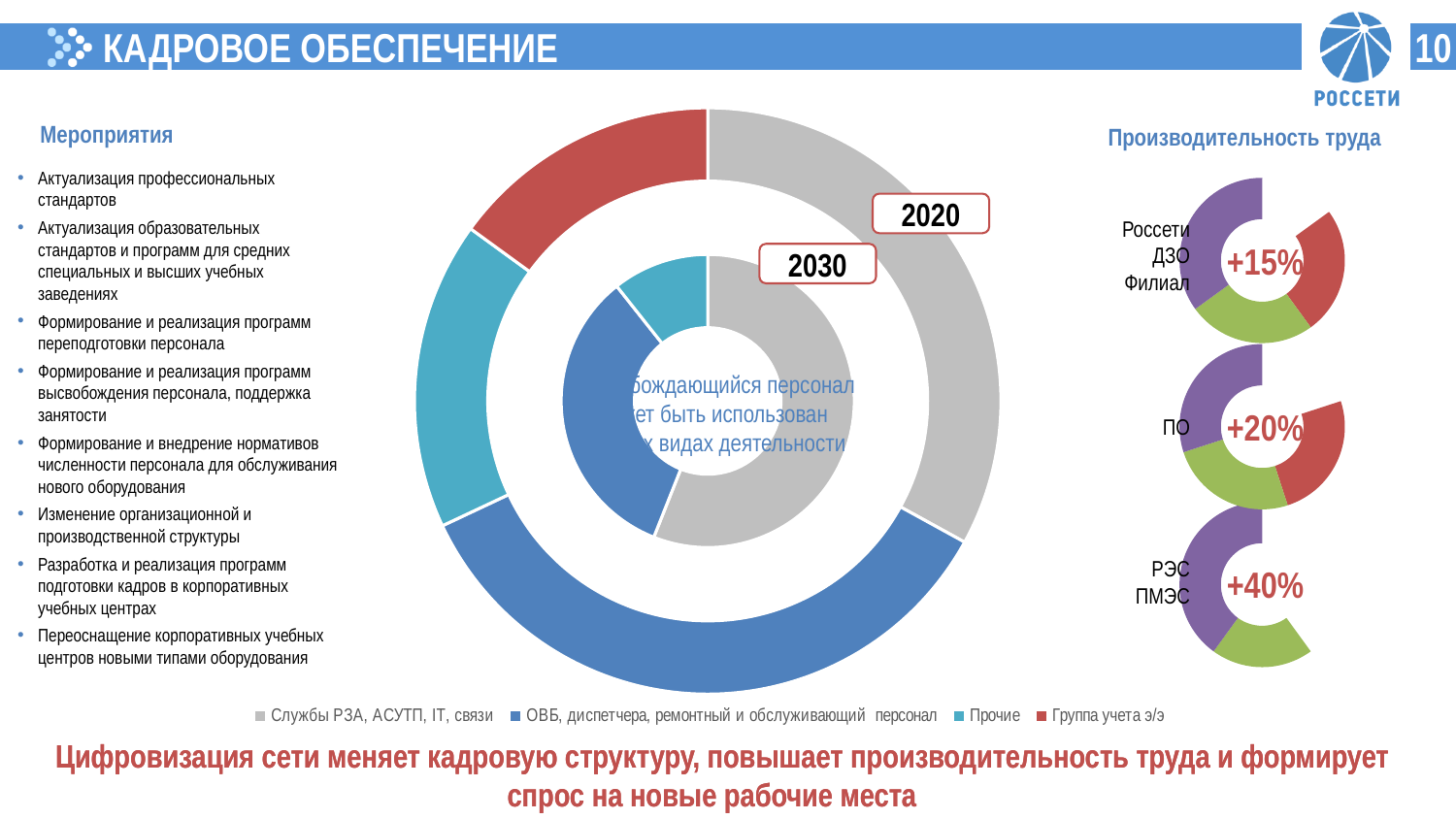
In the central doughnut chart, which year does the outer ring represent? 2020 In the central doughnut chart, which legend entry is shown in red? Группа учета э/э In the Производительность труда charts, which level has the lowest value? Россети ДЗО Филиал How many series does the legend of the central doughnut chart list? 4 How many rings (years) does the central doughnut chart show? 2 In the Производительность труда charts, what value is shown for РЭС ПМЭС? +40% In the Производительность труда charts, what value is shown for ПО? +20% In the central doughnut chart's 2020 ring, which is larger: Службы РЗА, АСУТП, IT, связи or Группа учета э/э? Службы РЗА, АСУТП, IT, связи In the Производительность труда charts, what is the difference between the values for РЭС ПМЭС and Россети ДЗО Филиал? 25% What kind of chart is the large chart in the centre of the slide? Doughnut chart In the central doughnut chart, which category has the largest share in the 2030 ring? Службы РЗА, АСУТП, IT, связи